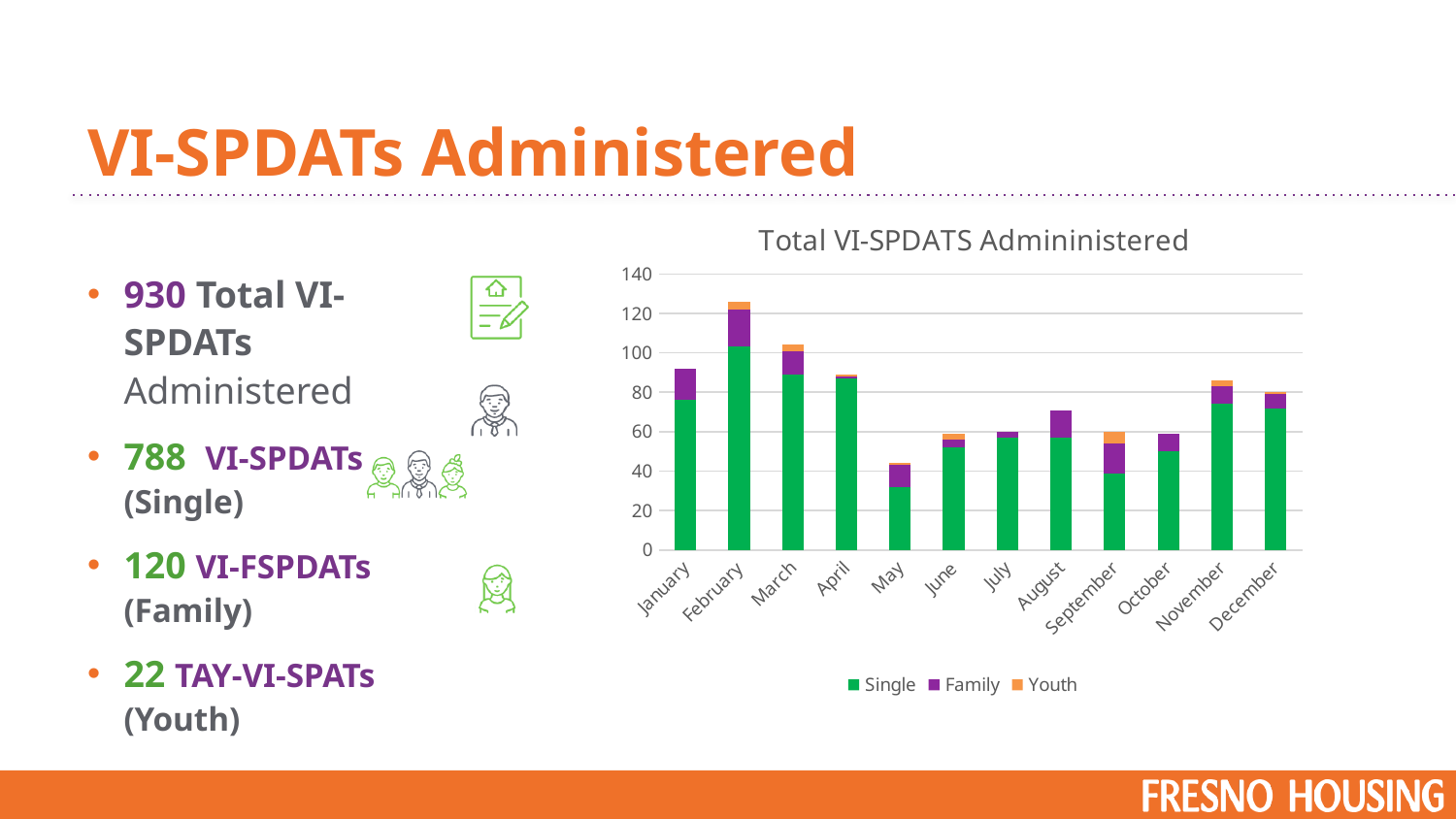
How many series does the chart's legend list? 3 Which month has a larger total bar, February or March? February Which month has the highest total bar in the chart? February How many months are shown on the x axis of the chart? 12 Is the total value for February greater or less than 100? greater Is the total value for May greater or less than 60? less Which month has the lowest total bar in the chart? May Which month has a larger total bar, May or June? June Is the total value for April greater or less than 100? less What kind of chart is shown on the slide? Stacked bar chart What are the three series listed in the chart's legend? Single, Family, Youth